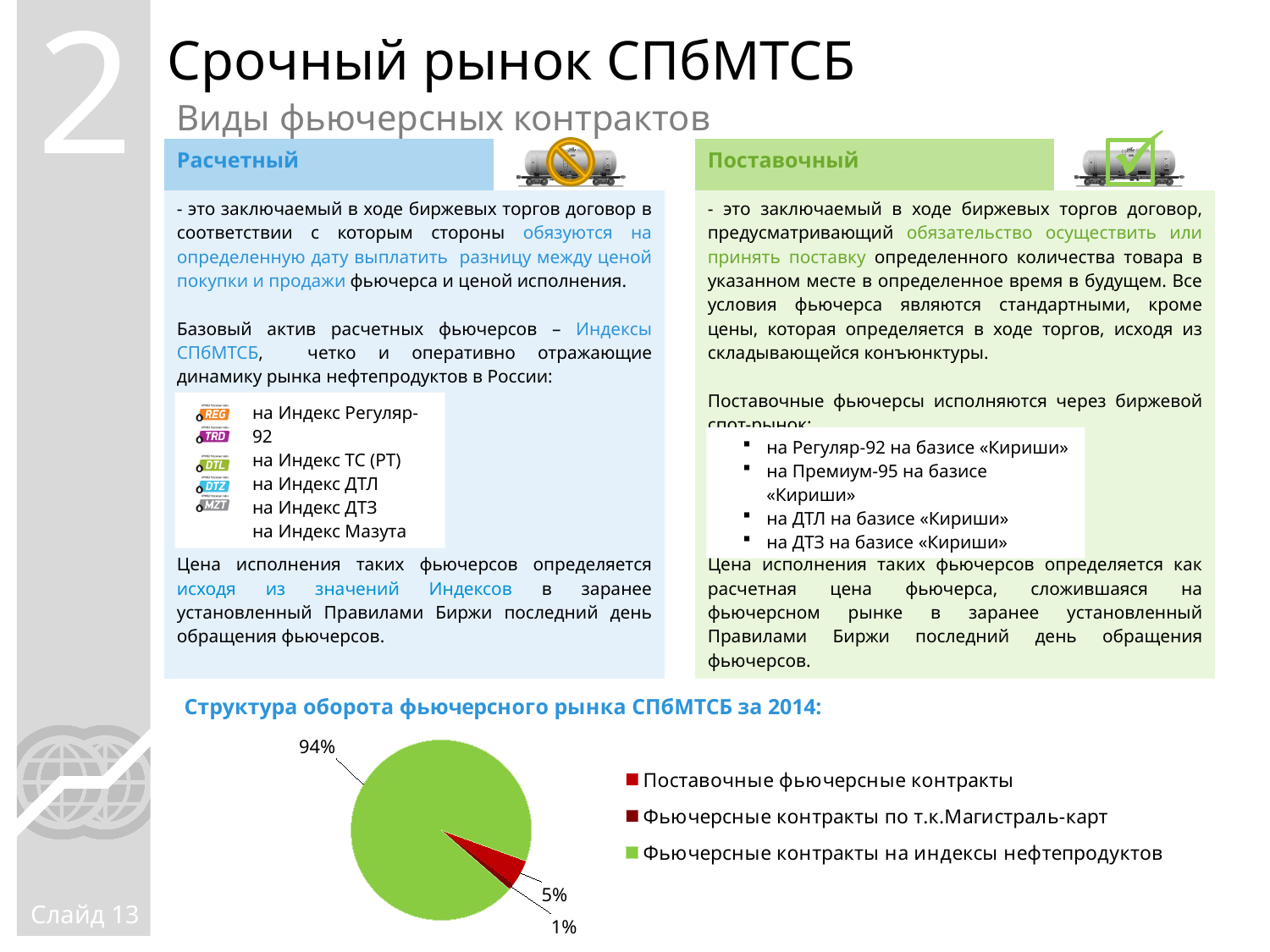
What is the difference in percentage points between the largest and smallest slices of the pie chart? 93 Which is larger in the pie chart: 'Поставочные фьючерсные контракты' or 'Фьючерсные контракты по т.к.Магистраль-карт'? Поставочные фьючерсные контракты What share of the pie chart is 'Фьючерсные контракты на индексы нефтепродуктов'? 94% What share of the pie chart is 'Поставочные фьючерсные контракты'? 5% Which category has the smallest slice in the pie chart? Фьючерсные контракты по т.к.Магистраль-карт What is the title of the chart on the slide? Структура оборота фьючерсного рынка СПбМТСБ за 2014: What share of the pie chart is 'Фьючерсные контракты по т.к.Магистраль-карт'? 1% Which category has the largest slice in the pie chart? Фьючерсные контракты на индексы нефтепродуктов How many entries does the legend of the pie chart list? 3 What colour is the slice for 'Фьючерсные контракты на индексы нефтепродуктов' in the pie chart? green What kind of chart is shown at the bottom of the slide? pie chart How many slices does the pie chart have? 3